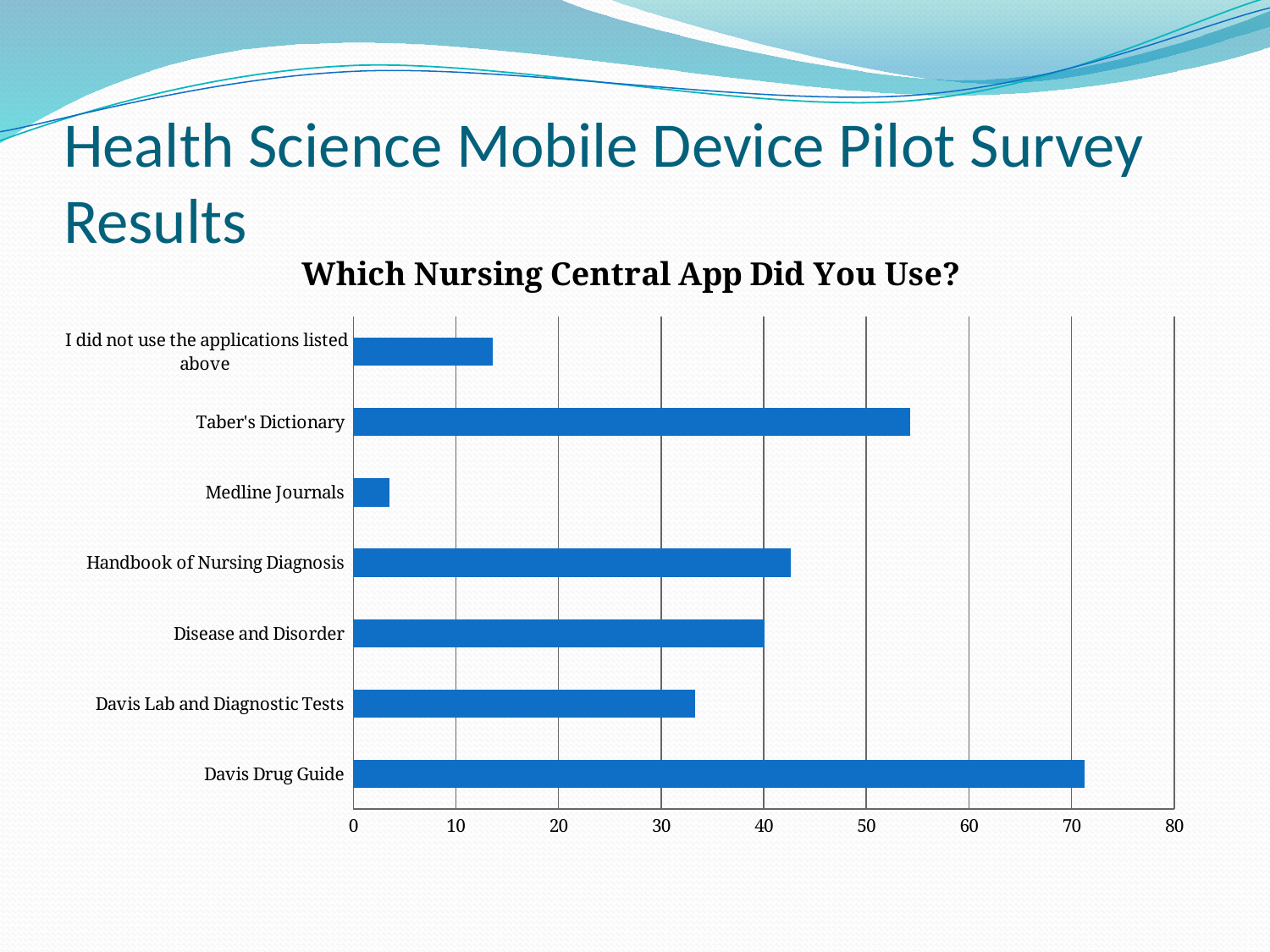
Which is larger, the value for Taber's Dictionary or the value for Handbook of Nursing Diagnosis? Taber's Dictionary Which category has the highest value? Davis Drug Guide Is the value for Medline Journals greater or less than 10? less How many categories (apps/responses) are plotted in the chart? 7 Is the value for Davis Lab and Diagnostic Tests greater or less than 30? greater What is the maximum value shown on the horizontal axis? 80 Is the value for Taber's Dictionary greater or less than 50? greater Which category has the lowest value? Medline Journals What kind of chart is shown on the slide? bar chart Which is larger, the value for Davis Lab and Diagnostic Tests or the value for I did not use the applications listed above? Davis Lab and Diagnostic Tests What is the title of the chart? Which Nursing Central App Did You Use?